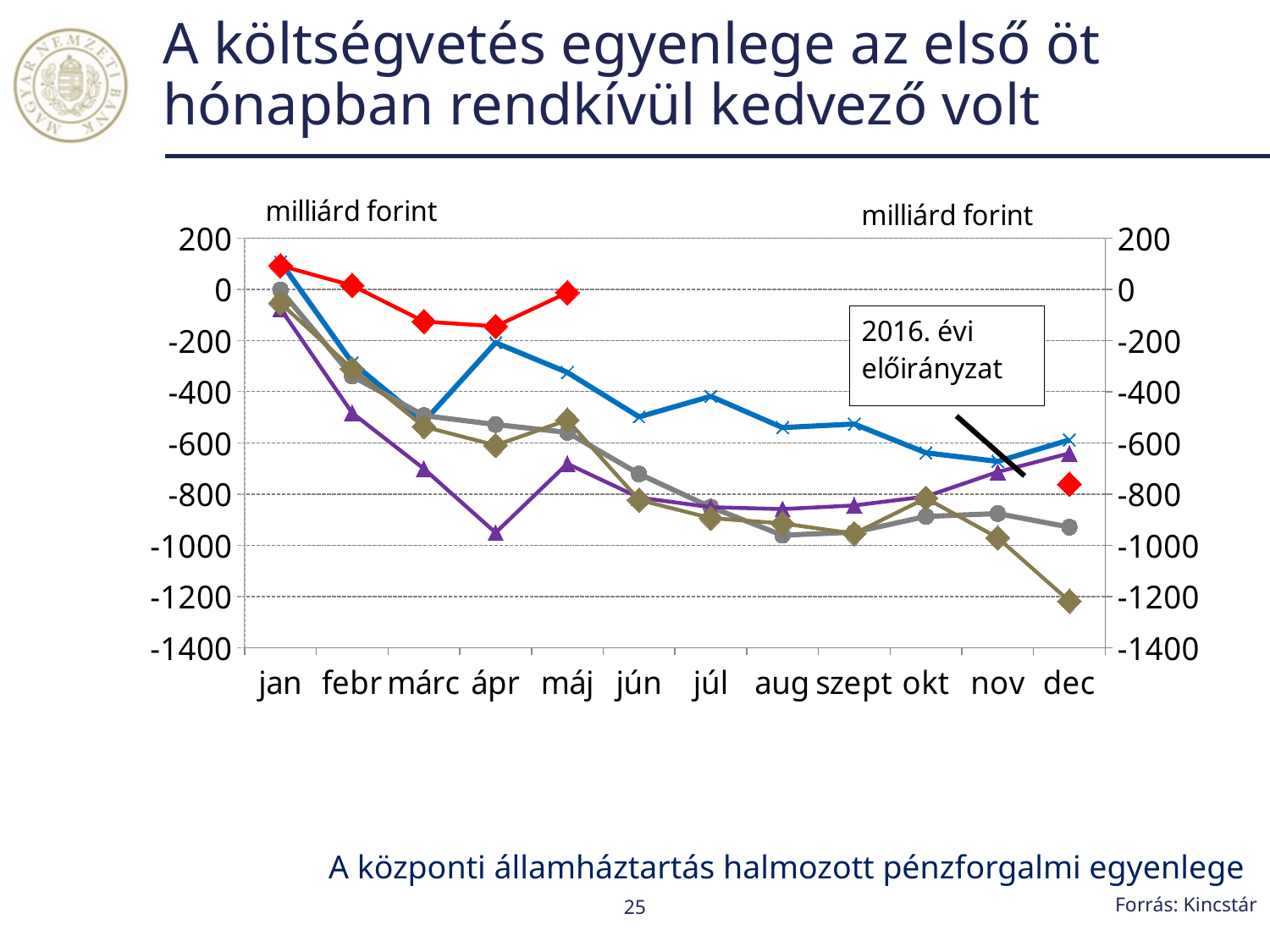
What kind of chart is shown on the slide? line chart Is the value of the olive diamond line in dec greater or less than -1000? less Is the value of the blue line in aug greater or less than -400? less What unit is shown on the vertical axes of the chart? milliárd forint Is the value of the red diamond line in ápr greater or less than 0? less What does the text box annotation inside the chart say? 2016. évi előirányzat In dec, which is higher: the blue line or the olive diamond line? the blue line Does the red diamond line rise or fall from jan to márc? fall In ápr, which is higher: the red diamond line or the purple triangle line? the red diamond line How many months are shown on the x axis of the chart? 12